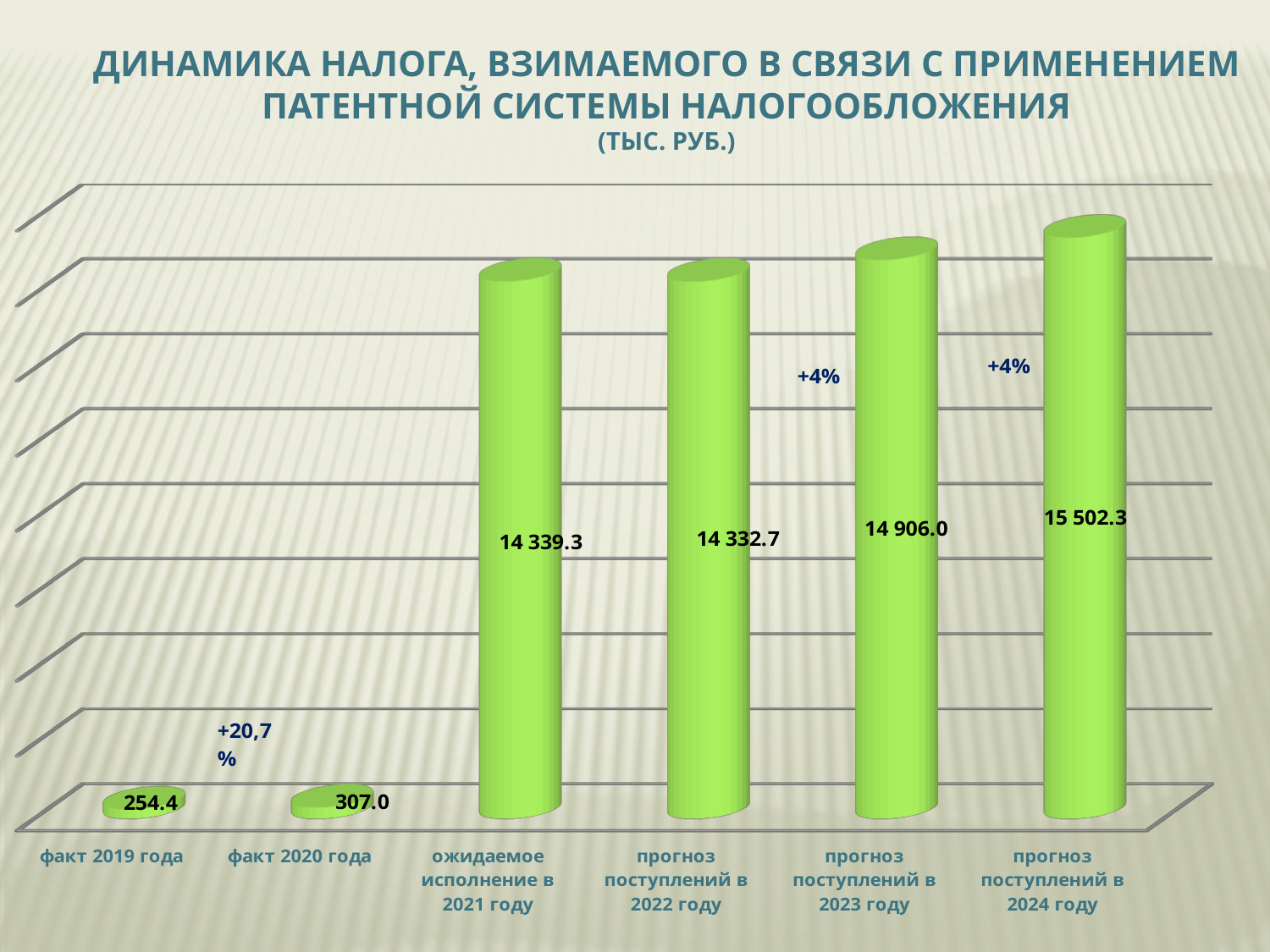
What is the difference between the values for факт 2020 года and факт 2019 года? 52.6 What is the value for ожидаемое исполнение в 2021 году? 14 339.3 What is the value for прогноз поступлений в 2024 году? 15 502.3 What kind of chart is shown on the slide? bar chart What is the value for факт 2019 года? 254.4 Which category has the lowest value? факт 2019 года What is the difference between the values for прогноз поступлений в 2024 году and прогноз поступлений в 2023 году? 596.3 How many categories are shown on the chart? 6 Which is larger, the value for прогноз поступлений в 2023 году or прогноз поступлений в 2022 году? прогноз поступлений в 2023 году In what units are the values on the chart given, according to the subtitle? тыс. руб. What is the value for прогноз поступлений в 2023 году? 14 906.0 Which category has the highest value? прогноз поступлений в 2024 году